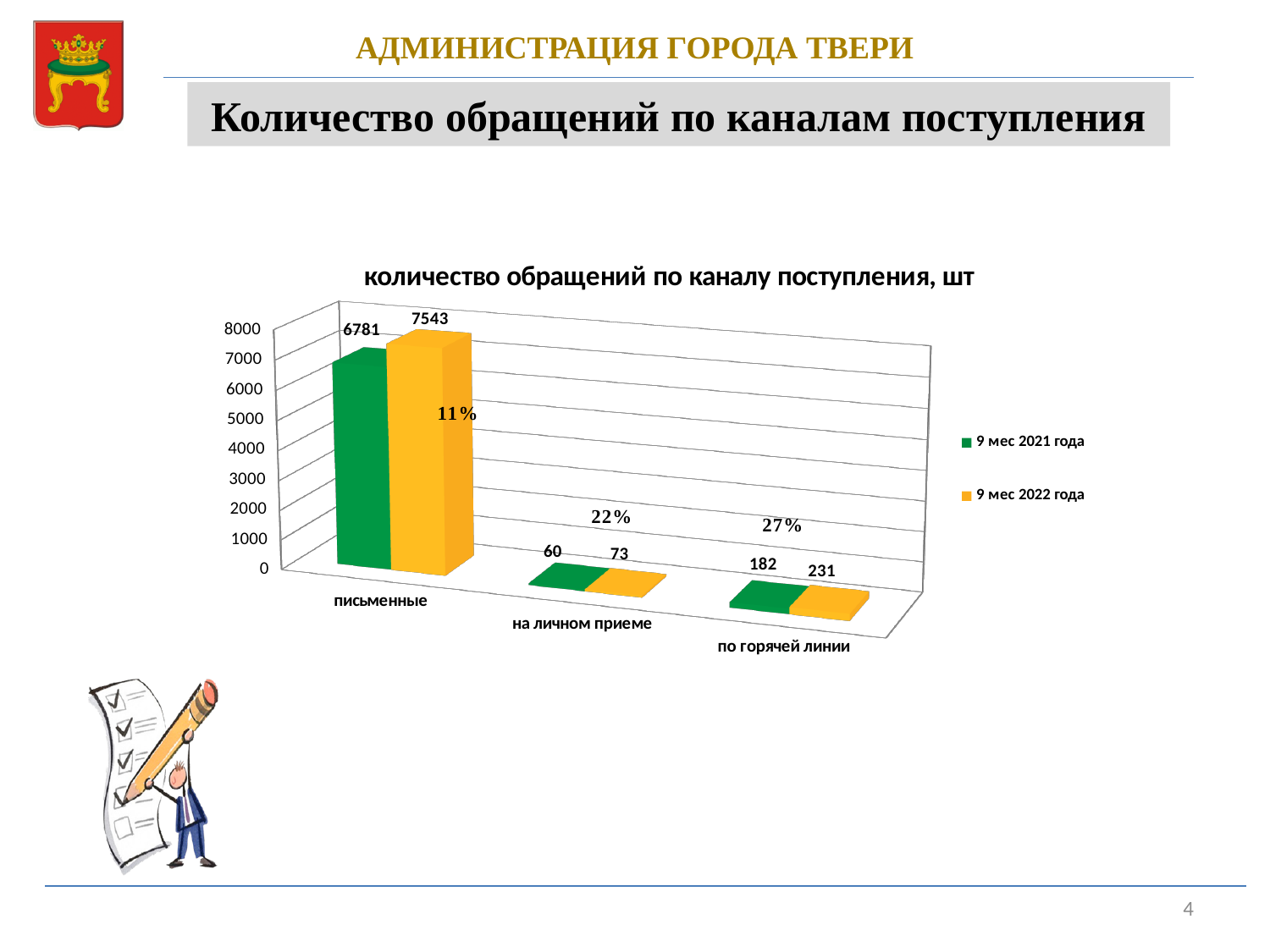
How many categories are shown on the x axis? 3 What kind of chart is shown on the slide? bar chart What is the difference between the 9 мес 2022 года and 9 мес 2021 года values for по горячей линии? 49 What is the value for по горячей линии in the 9 мес 2022 года series? 231 What is the value for на личном приеме in the 9 мес 2021 года series? 60 What is the value for письменные in the 9 мес 2021 года series? 6781 Which category has the lowest value in the 9 мес 2021 года series? на личном приеме What is the value for письменные in the 9 мес 2022 года series? 7543 How many series does the legend list? 2 What is the difference between the 9 мес 2022 года and 9 мес 2021 года values for письменные? 762 Which is larger for на личном приеме: the 9 мес 2021 года value or the 9 мес 2022 года value? 9 мес 2022 года Which category has the highest value in the 9 мес 2022 года series? письменные